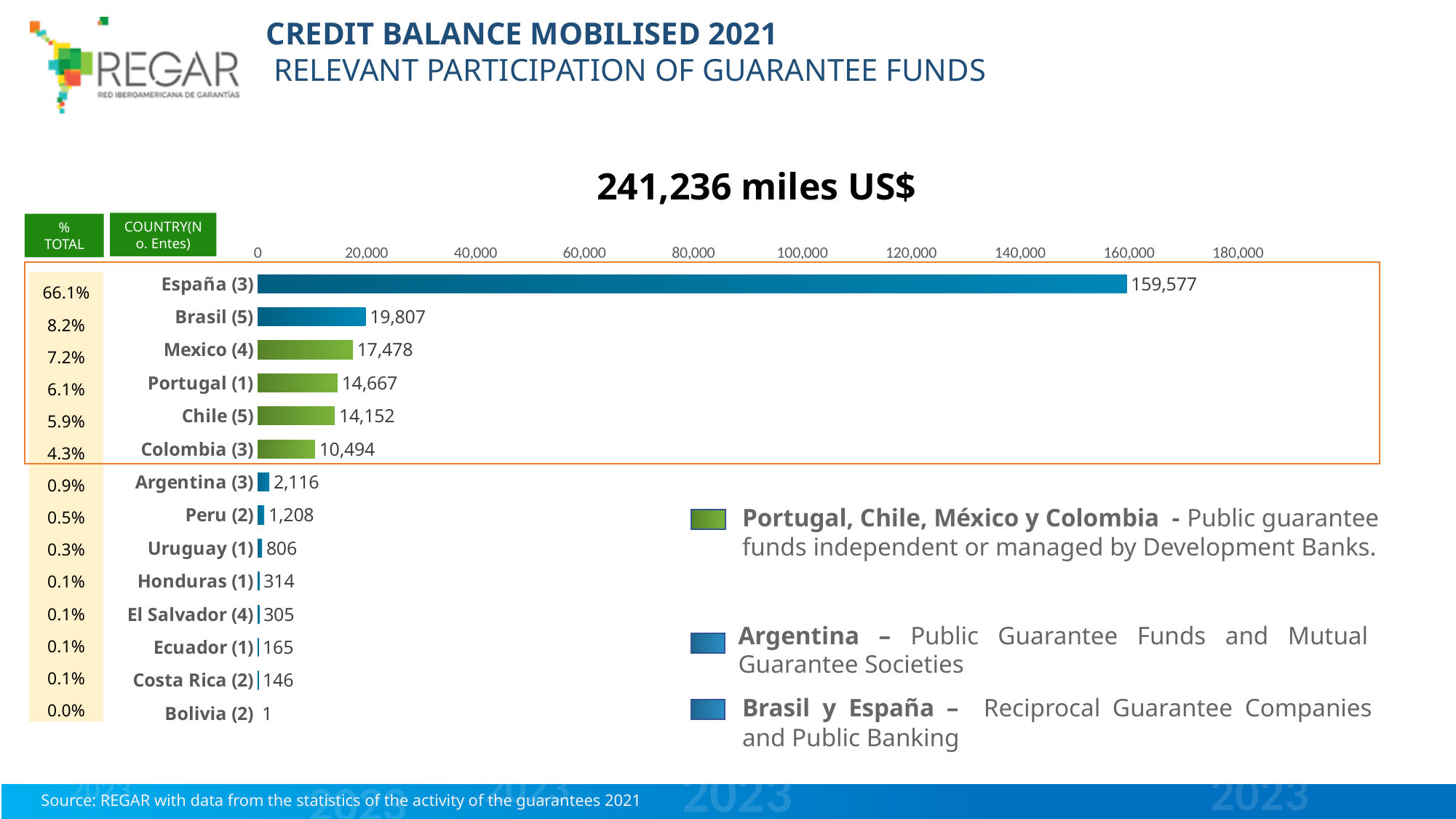
What is the credit balance mobilised value shown for España (3)? 159,577 What kind of chart is shown on the slide? Bar chart What value is shown for Colombia (3)? 10,494 Which country has the lowest credit balance mobilised? Bolivia (2) Is the value for España (3) greater or less than 140,000? greater What percentage of the total is shown for España (3) in the % TOTAL column? 66.1% Which country has the highest credit balance mobilised? España (3) Which is larger, the value for Chile (5) or the value for Colombia (3)? Chile (5) What is the difference between the values for Brasil (5) and Mexico (4)? 2,329 How many countries are shown in the chart? 14 What is the difference between the values for Portugal (1) and Chile (5)? 515 What value is shown for Argentina (3)? 2,116